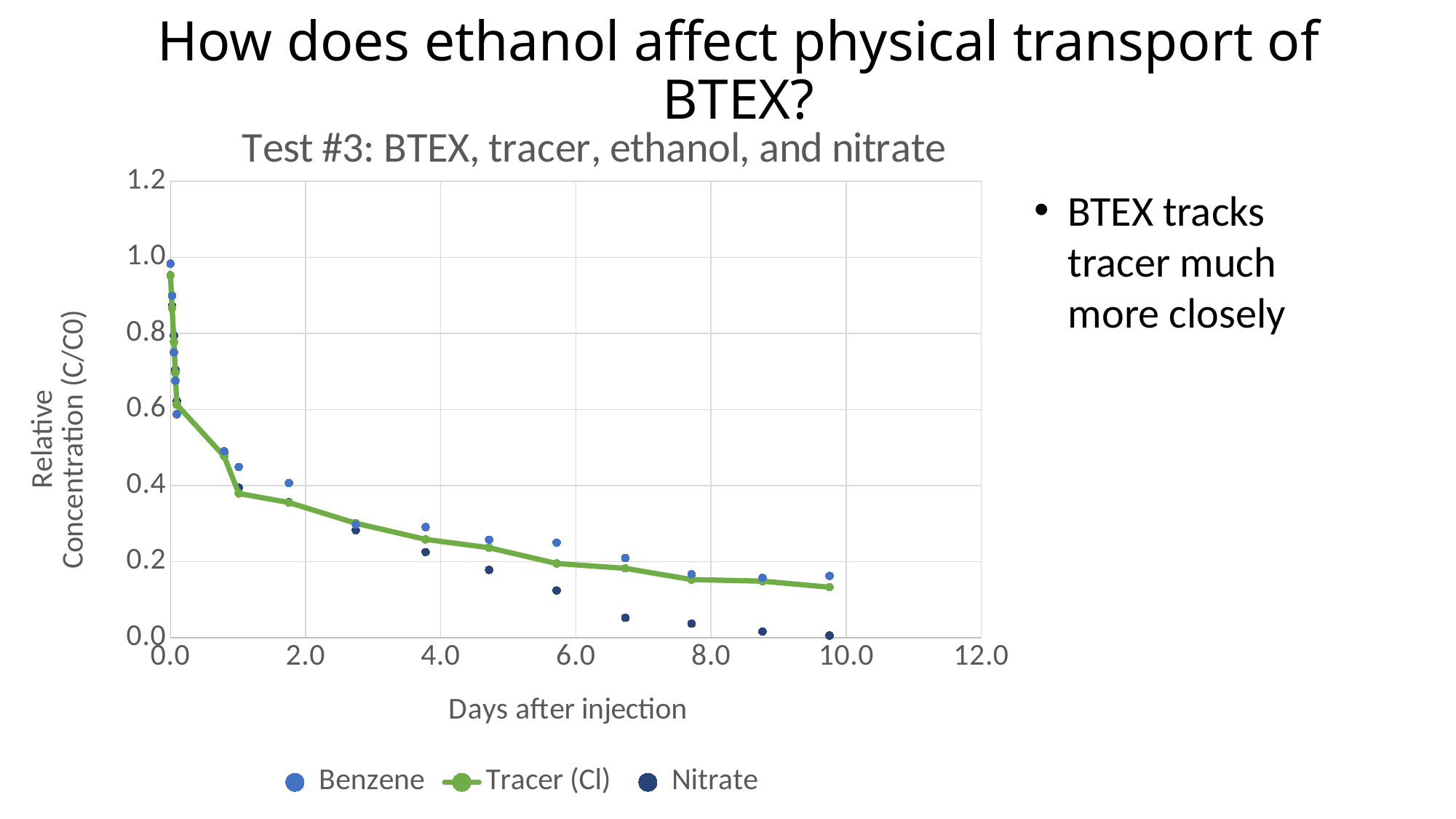
Is the Tracer (Cl) value at about day 1.0 greater or less than 0.6? less Which series has the lowest value at about day 9.8? Nitrate What is the title of the chart? Test #3: BTEX, tracer, ethanol, and nitrate How many series does the chart legend list? 3 What is the label of the x axis? Days after injection At about day 9.8, which is larger: the Benzene value or the Nitrate value? Benzene What kind of chart is shown on the slide? scatter chart Is the Benzene value at day 0 greater or less than 0.8? greater At about day 7.7, which is larger: the Tracer (Cl) value or the Nitrate value? Tracer (Cl) Is the Benzene value at about day 0.8 greater or less than 0.4? greater Do the Tracer (Cl) values rise or fall as days after injection increase? fall